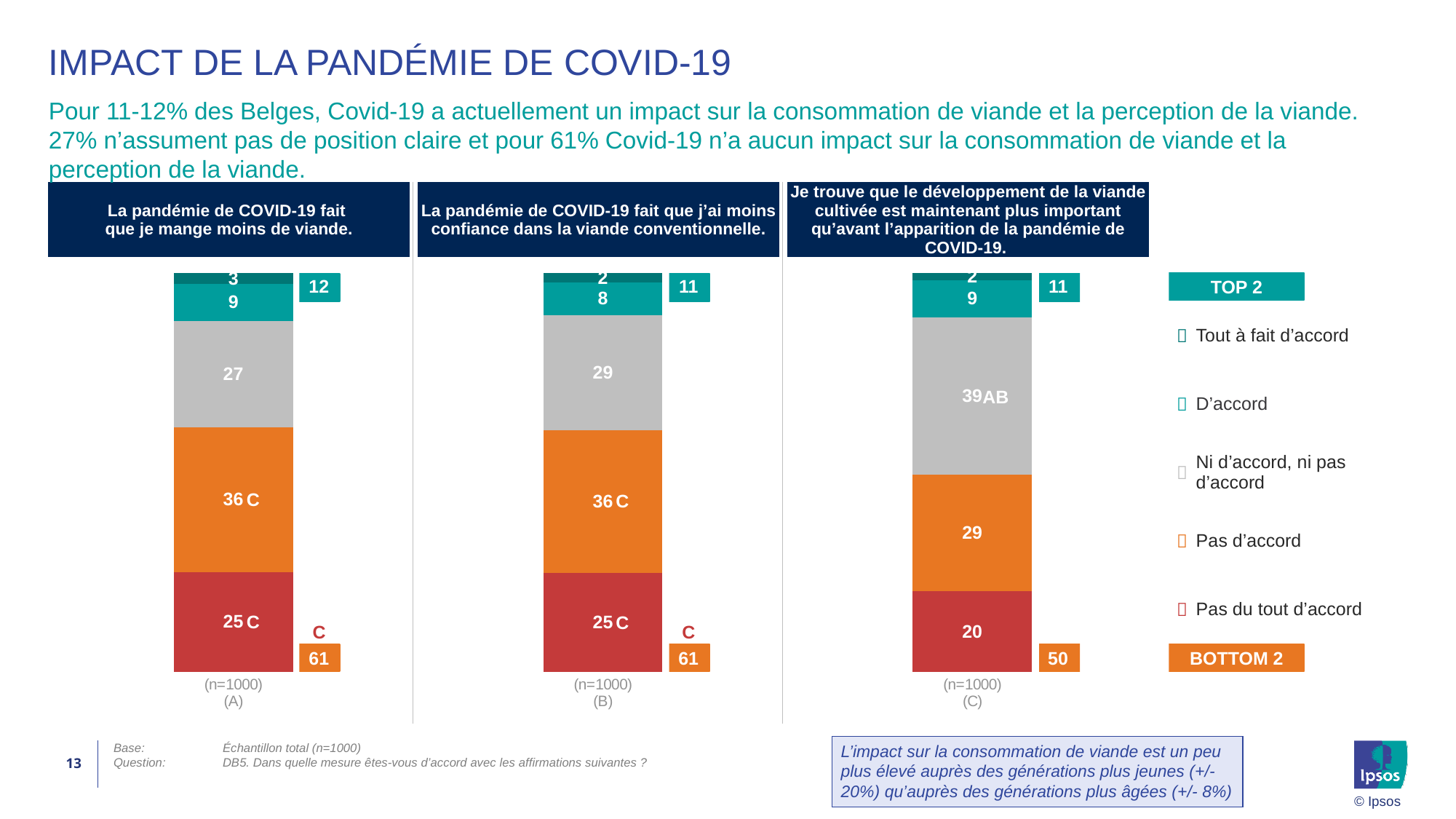
In the right chart (about "viande cultivée"), what is the BOTTOM 2 value? 50 In the right chart (about "viande cultivée"), what is the value for "Ni d'accord, ni pas d'accord"? 39 In the middle chart ("...moins confiance dans la viande conventionnelle"), what is the difference between the "Pas d'accord" value and the "Pas du tout d'accord" value? 11 In the left chart ("...je mange moins de viande"), what is the TOP 2 value? 12 How many response categories does the legend list? 5 In the left chart ("...je mange moins de viande"), which response category has the highest value? Pas d'accord In the middle chart ("...moins confiance dans la viande conventionnelle"), what is the value for "Pas d'accord"? 36 In the left chart ("La pandémie de COVID-19 fait que je mange moins de viande"), what is the value for "Ni d'accord, ni pas d'accord"? 27 In the right chart (about "viande cultivée"), which response category has the lowest value? Tout à fait d'accord In the right chart (about "viande cultivée"), which is larger: the value for "Pas d'accord" or the value for "Pas du tout d'accord"? Pas d'accord What is the sample size (n) shown under each bar? n=1000 What kind of chart is used on this slide? Stacked bar chart